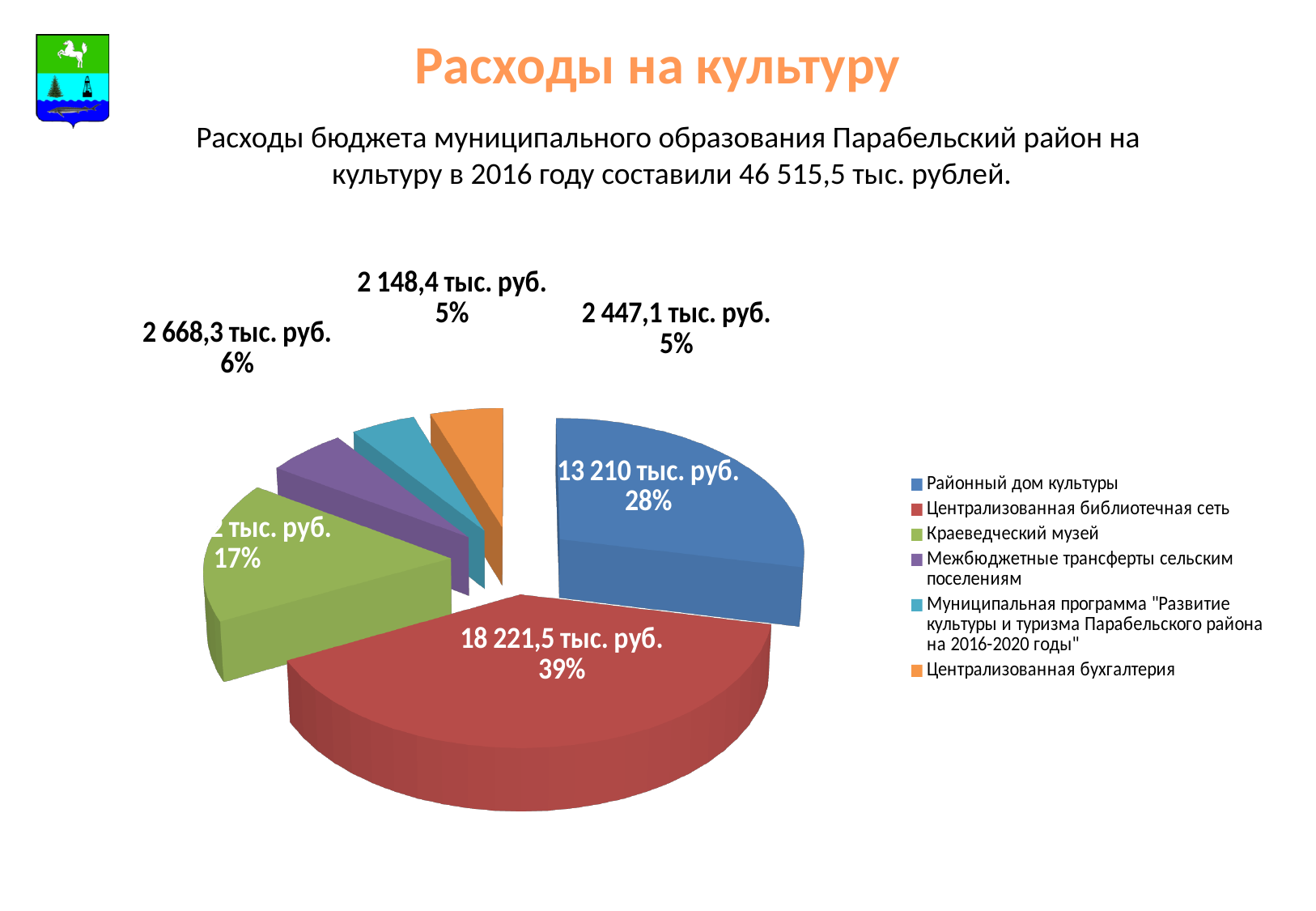
What is the value for Межбюджетные трансферты сельским поселениям? 2 668,3 тыс. руб. What is the value for Районный дом культуры? 13 210 тыс. руб. What share of the pie does Краеведческий музей represent? 17% How many slices does the pie chart have? 6 What is the difference between the values for Централизованная библиотечная сеть and Районный дом культуры? 5 011,5 тыс. руб. What is the value for Централизованная библиотечная сеть? 18 221,5 тыс. руб. Which is larger: the value for Районный дом культуры or the value for Краеведческий музей? Районный дом культуры How many entries does the legend of the pie chart list? 6 What kind of chart is shown on the slide? pie chart Which category has the largest slice of the pie? Централизованная библиотечная сеть What share of the pie does Централизованная библиотечная сеть represent? 39% What is the title of the slide containing the pie chart? Расходы на культуру